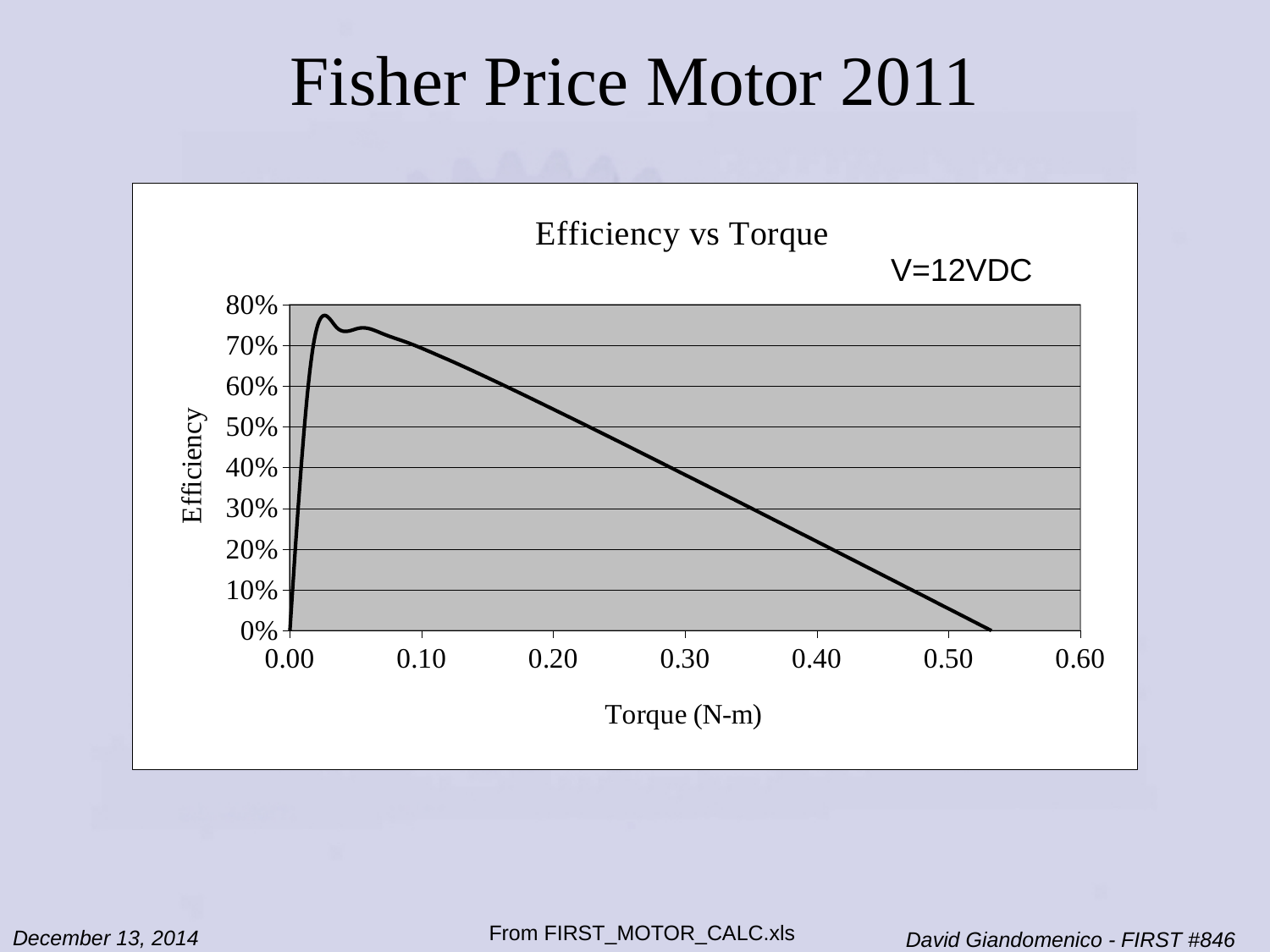
Is the peak efficiency on the curve greater or less than 70%? greater What kind of chart is shown on the slide? line chart Does the efficiency rise or fall as torque increases from 0.10 N-m to 0.50 N-m? fall Is the peak efficiency on the curve greater or less than 80%? less What is the highest value shown on the efficiency axis? 80% What is the label of the x axis of the chart? Torque (N-m) Is the efficiency at a torque of 0.10 N-m greater or less than 60%? greater Is the efficiency at a torque of 0.10 N-m higher or lower than at 0.40 N-m? higher What is the title of the chart? Efficiency vs Torque